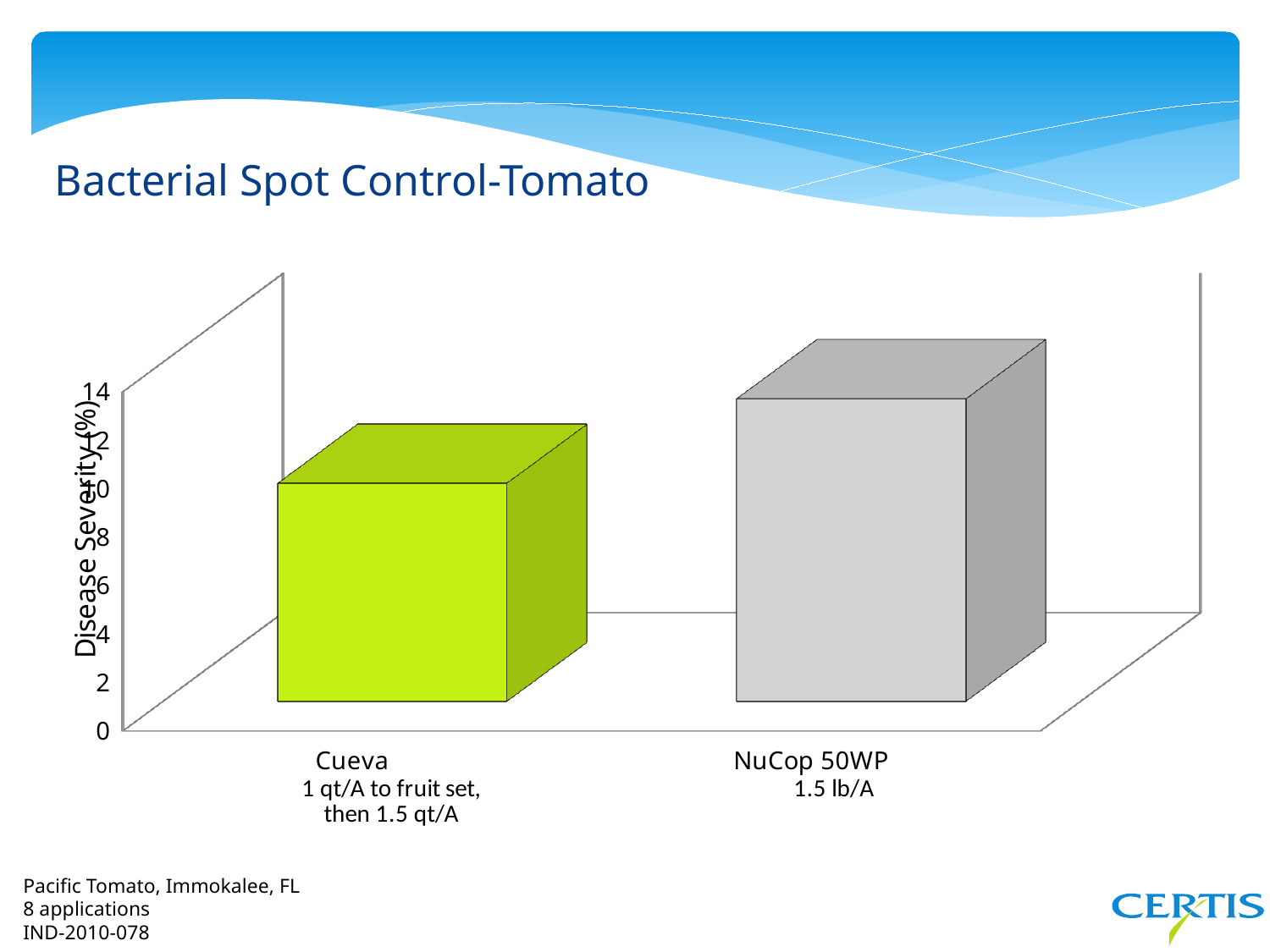
Is the disease severity for Cueva greater or less than 12? less How many categories (treatments) are plotted in the chart? 2 What type of chart is shown on the slide? bar chart Is the disease severity for NuCop 50WP greater or less than 4? greater Which treatment has the highest disease severity? NuCop 50WP What is the title of the slide containing the chart? Bacterial Spot Control-Tomato Which treatment has the lowest disease severity? Cueva Which has a higher disease severity, Cueva or NuCop 50WP? NuCop 50WP Is the disease severity for Cueva greater or less than 6? greater What is the label of the vertical axis? Disease Severity (%)